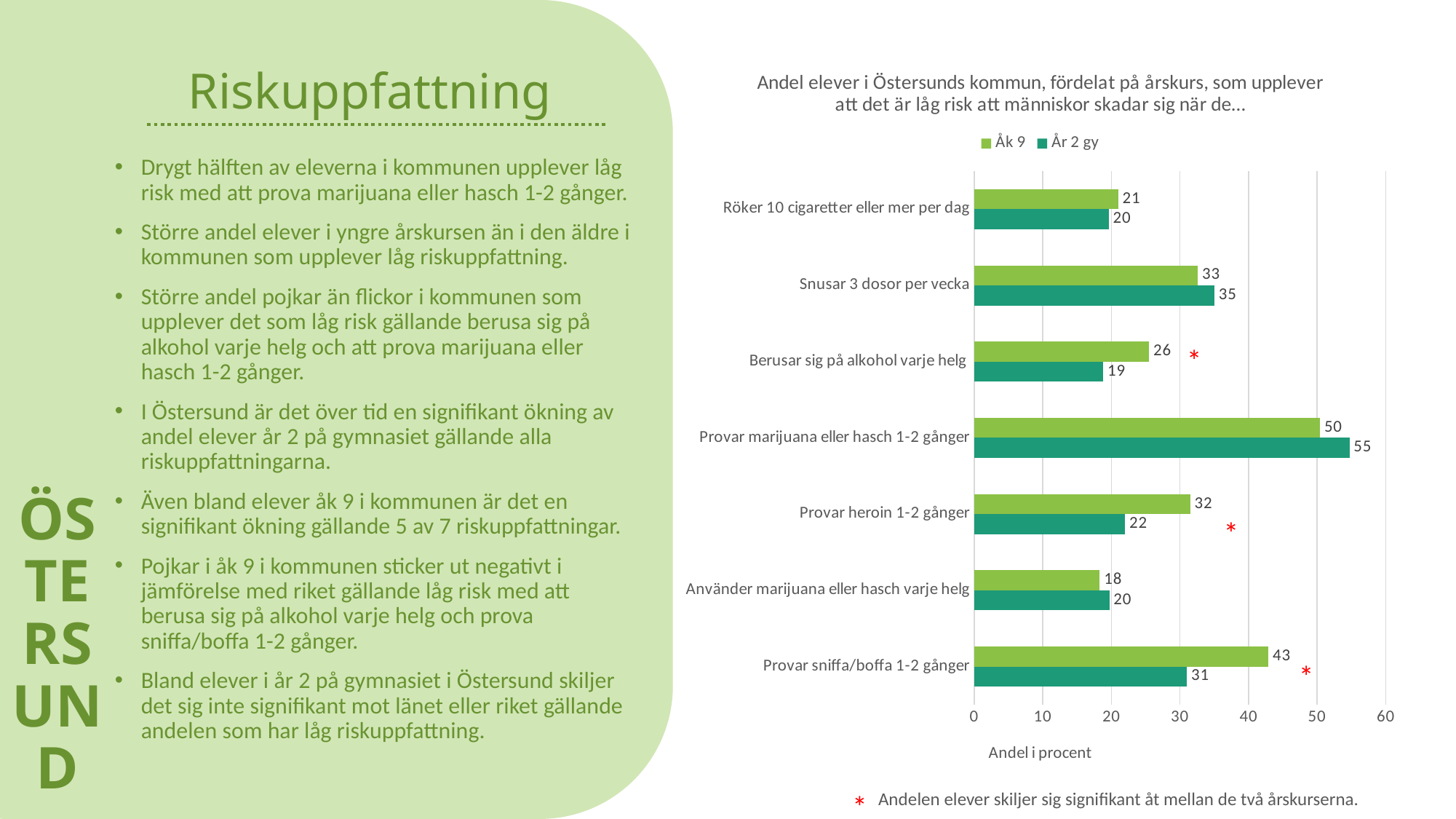
Which category has the lowest value for Åk 9? Använder marijuana eller hasch varje helg What is the value for Åk 9 for "Provar sniffa/boffa 1-2 gånger"? 43 How many categories are shown on the chart? 7 What is the value for År 2 gy for "Berusar sig på alkohol varje helg"? 19 What kind of chart is shown on the slide? Bar chart What is the value for Åk 9 for "Provar marijuana eller hasch 1-2 gånger"? 50 Is the År 2 gy value for "Snusar 3 dosor per vecka" greater or less than 30? greater What is the difference between the Åk 9 and År 2 gy values for "Provar sniffa/boffa 1-2 gånger"? 12 Which category has the highest value for År 2 gy? Provar marijuana eller hasch 1-2 gånger For "Provar heroin 1-2 gånger", which series has the larger value, Åk 9 or År 2 gy? Åk 9 How many series does the legend list? 2 What is the label of the x axis of the chart? Andel i procent